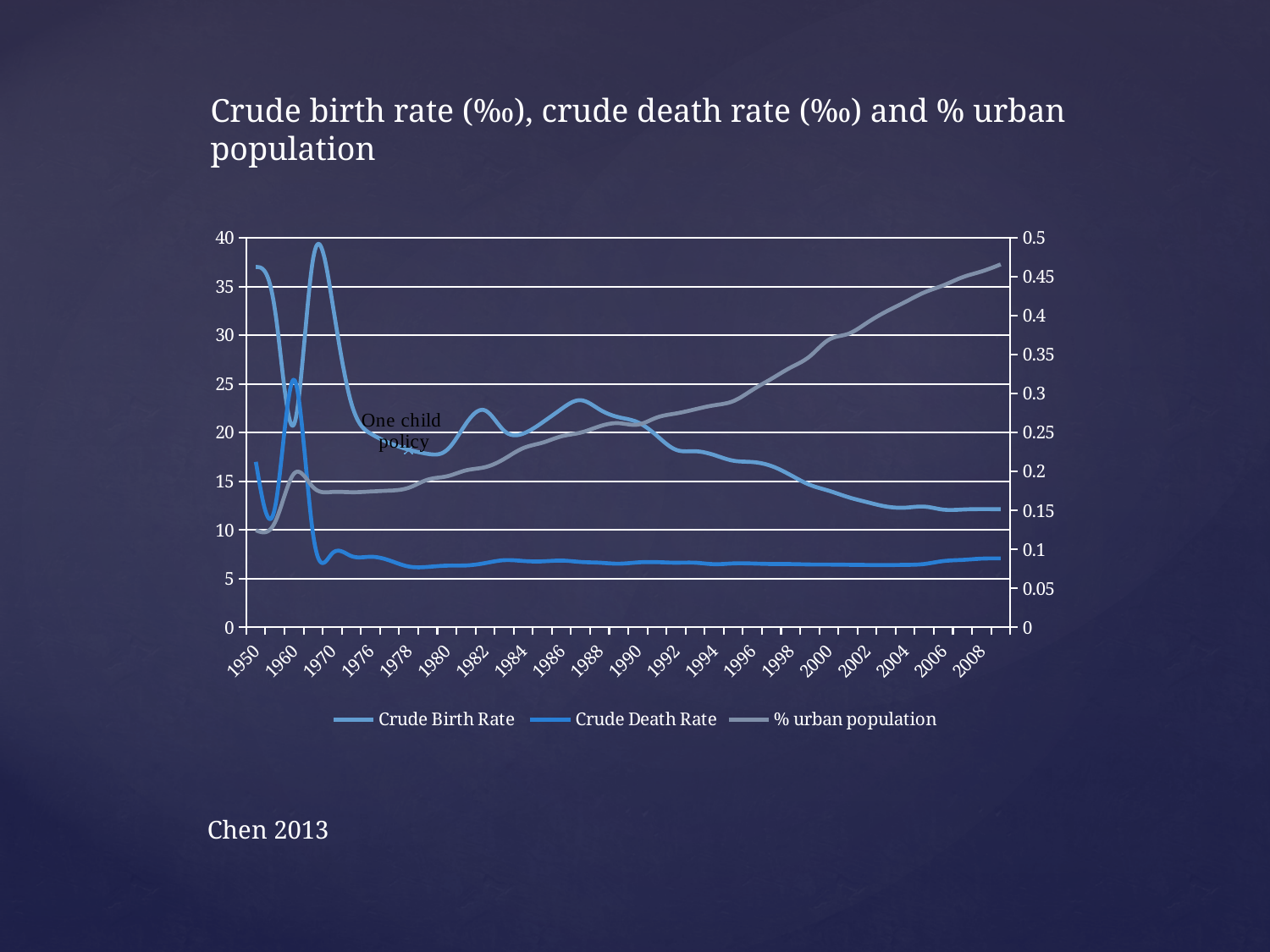
How many series does the legend list? 3 Is the value for Crude Birth Rate in 1950 greater or less than 35? greater What event is annotated on the chart near 1978? One child policy Is the value for % urban population in 1950 greater or less than 0.15? less What is the title of the chart? Crude birth rate (‰), crude death rate (‰) and % urban population Is the value for Crude Death Rate in 2008 greater or less than 10? less Does the % urban population series rise or fall from 1950 to 2008? rise What kind of chart is shown on the slide? line chart In 2008, which is larger, the Crude Birth Rate or the Crude Death Rate? Crude Birth Rate Does the Crude Birth Rate series rise or fall from 1970 to 2008? fall